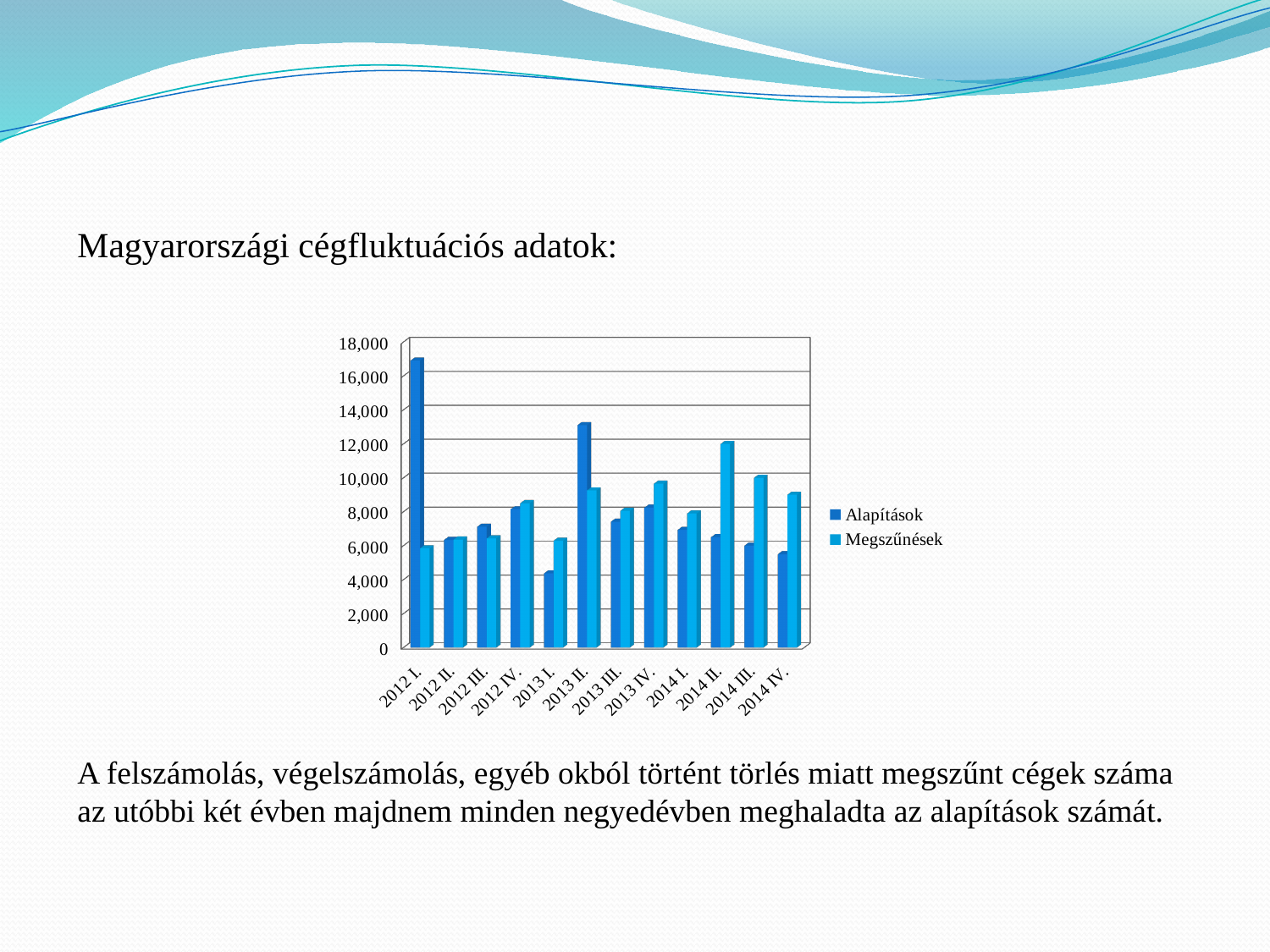
Which quarter has the lowest value for Alapítások? 2013 I. Is the value for Alapítások in 2013 II. greater or less than 12,000? greater Is the value for Alapítások in 2013 I. greater or less than 6,000? less In 2012 I., which is larger: Alapítások or Megszűnések? Alapítások Which quarter has the highest value for Megszűnések? 2014 II. What kind of chart is shown on the slide? bar chart In 2014 II., which is larger: Alapítások or Megszűnések? Megszűnések How many series does the chart legend list? 2 What are the two series named in the chart legend? Alapítások and Megszűnések How many quarters (categories) are shown on the x axis of the chart? 12 Is the value for Alapítások in 2012 I. greater or less than 16,000? greater Which quarter has the highest value for Alapítások? 2012 I.